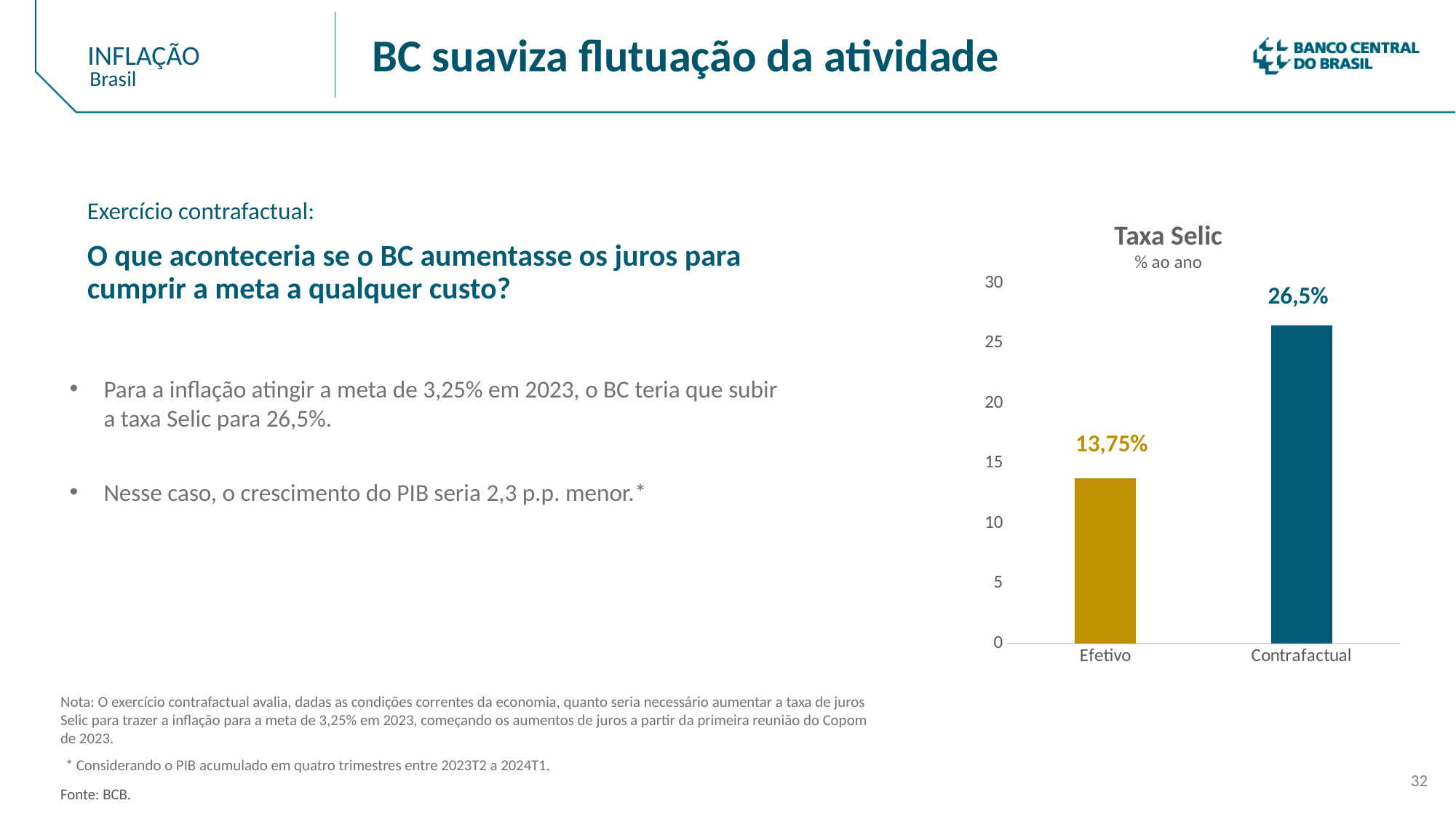
What kind of chart is the Taxa Selic chart? bar chart What is the title of the chart on the slide? Taxa Selic Is the value for Contrafactual greater or less than 25? greater Which category has the highest value in the Taxa Selic chart? Contrafactual What unit is shown under the chart title? % ao ano Is the value for Efetivo greater or less than 15? less How many categories are shown in the Taxa Selic chart? 2 Which is larger in the Taxa Selic chart, Efetivo or Contrafactual? Contrafactual Which category has the lowest value in the Taxa Selic chart? Efetivo What is the difference between the Contrafactual and Efetivo values in the Taxa Selic chart? 12,75 p.p. What is the value for Contrafactual in the Taxa Selic chart? 26,5% What is the value for Efetivo in the Taxa Selic chart? 13,75%